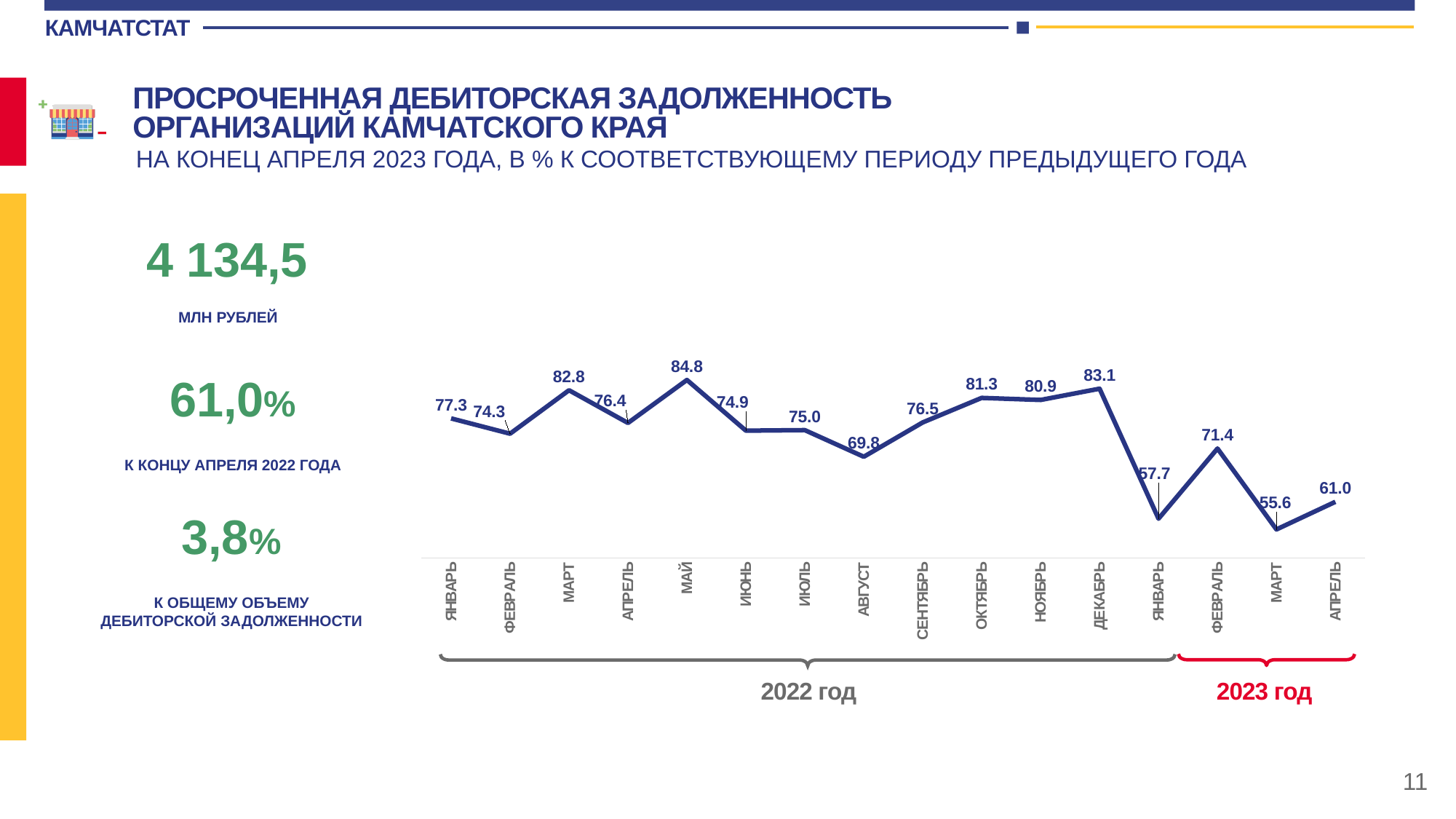
What is the difference between the values for April 2023 and April 2022? 15.4 What is the value for May 2022 on the line chart? 84.8 Which is larger, the value for October 2022 or the value for November 2022? October 2022 Does the line rise or fall from February 2023 to March 2023? fall Which month has the lowest value on the line chart? March 2023 Which two year groups are marked with brackets below the x axis of the chart? 2022 год and 2023 год Which month has the highest value on the line chart? May 2022 What is the difference between the values for December 2022 and January 2023? 25.4 What is the value for January 2023 on the line chart? 57.7 What type of chart is shown on the slide? line chart How many data points are plotted on the line chart? 16 What is the value for March 2023 on the line chart? 55.6